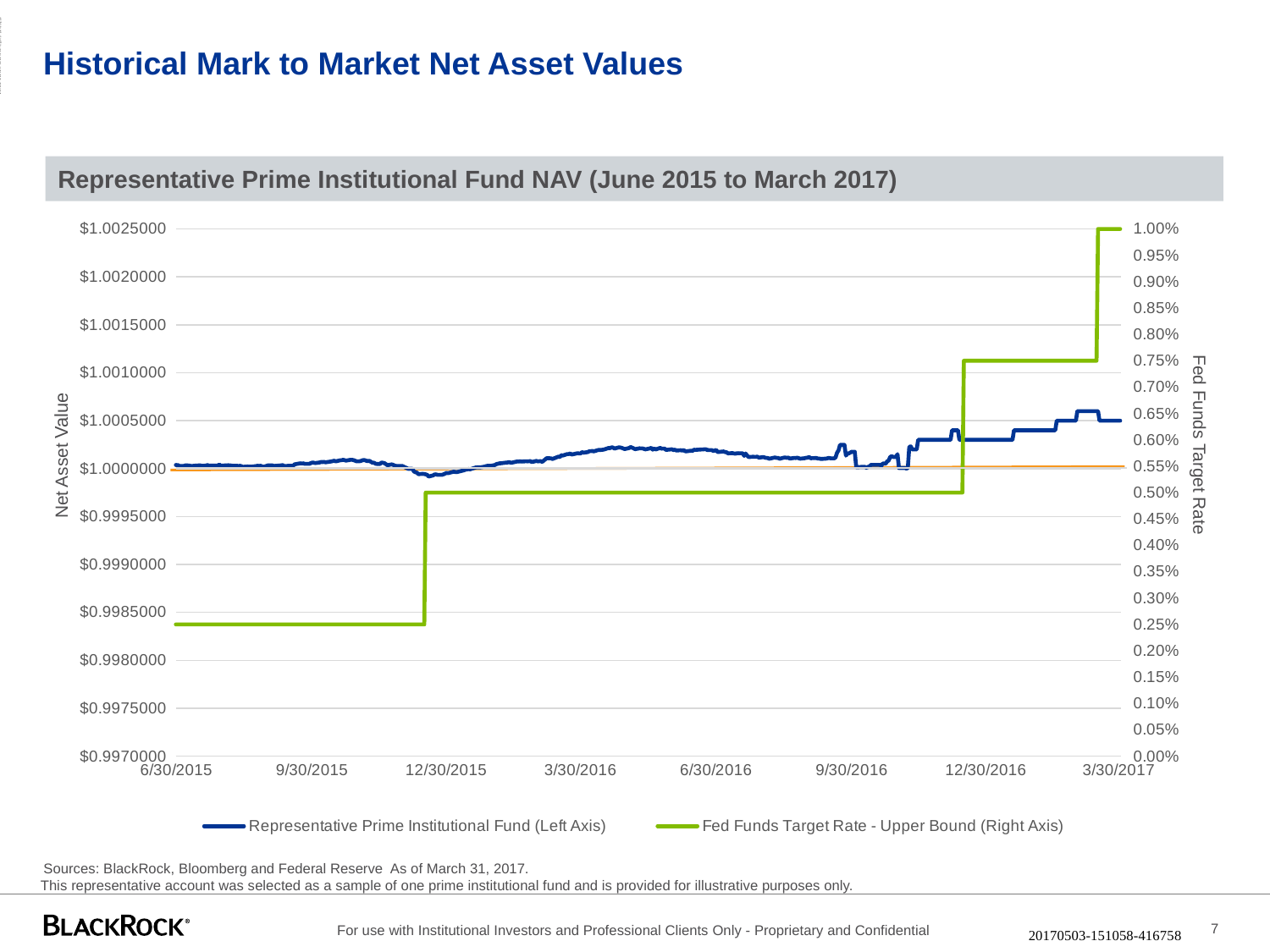
How many step increases does the Fed Funds Target Rate - Upper Bound line show over the period? 3 What is the Fed Funds Target Rate - Upper Bound at 6/30/2015? 0.25% By how much did the Fed Funds Target Rate - Upper Bound increase from 6/30/2015 to 3/30/2017? 0.75% What is the Fed Funds Target Rate - Upper Bound at 3/30/2017? 1.00% What is the title of the chart? Representative Prime Institutional Fund NAV (June 2015 to March 2017) Is the Representative Prime Institutional Fund NAV at 3/30/2017 greater or less than $1.0000000? greater What is the Fed Funds Target Rate - Upper Bound at 6/30/2016? 0.50% What is the highest value reached by the Fed Funds Target Rate - Upper Bound series? 1.00% Does the Fed Funds Target Rate - Upper Bound rise or fall over the period shown? rise What kind of chart is shown on the slide? line chart Which series is plotted on the right axis according to the legend? Fed Funds Target Rate - Upper Bound (Right Axis) How many series does the legend list? 2